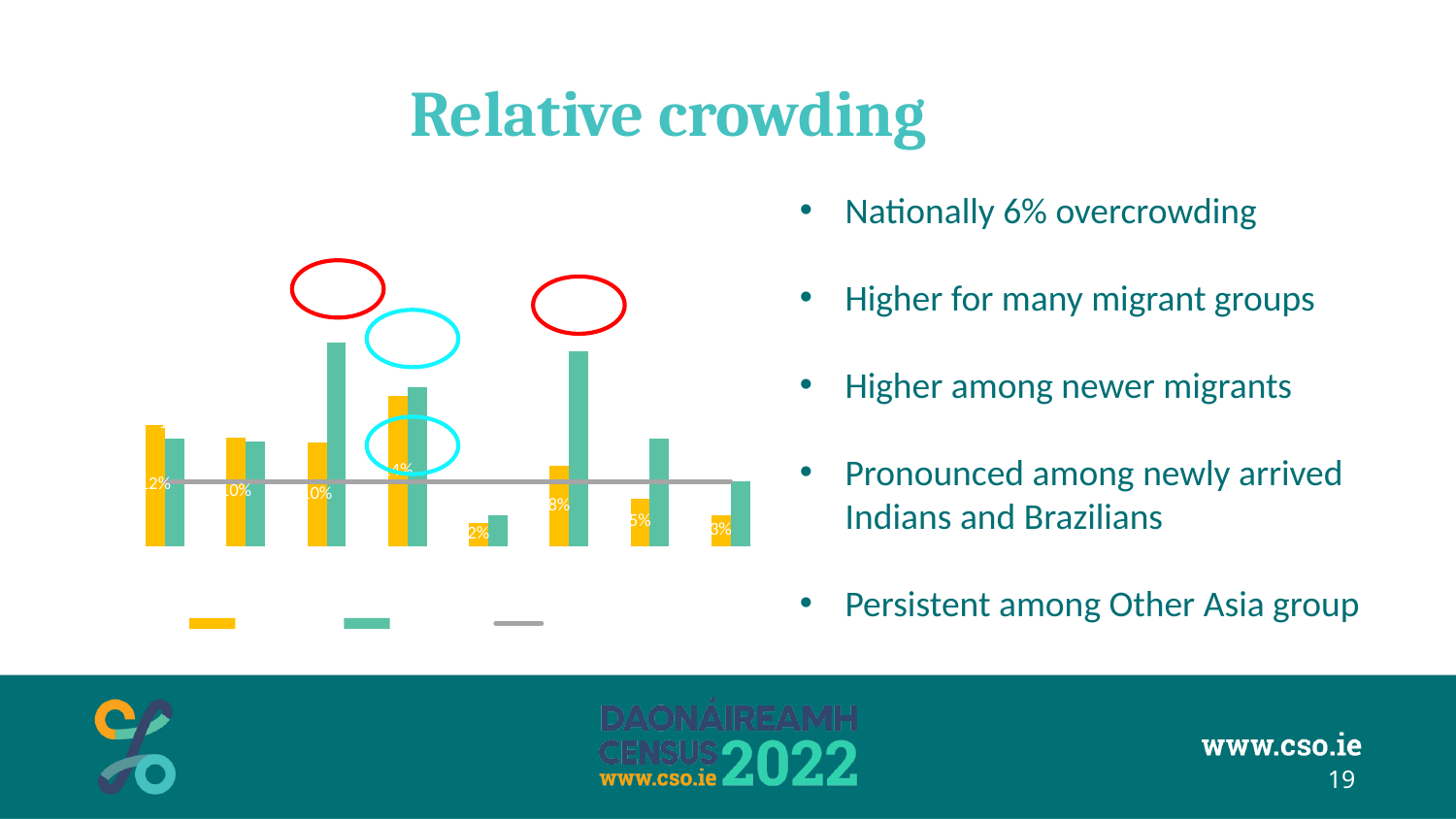
What kind of chart is shown on the slide? a combination bar and line chart What colours are the two bar series in the chart? yellow and green In the third group of bars from the left, which bar is taller, the yellow one or the green one? the green one How many entries does the chart's legend show? 3 In the sixth group of bars from the left, which bar is taller, the yellow one or the green one? the green one How many groups of bars are plotted along the x axis of the chart? 8 In the eighth group of bars from the left, which bar is taller, the yellow one or the green one? the green one Which group of bars, counting from the left, has the tallest yellow bar? the fourth group What colour is the horizontal line drawn across the chart? grey Which group of bars, counting from the left, has the shortest yellow bar? the fifth group